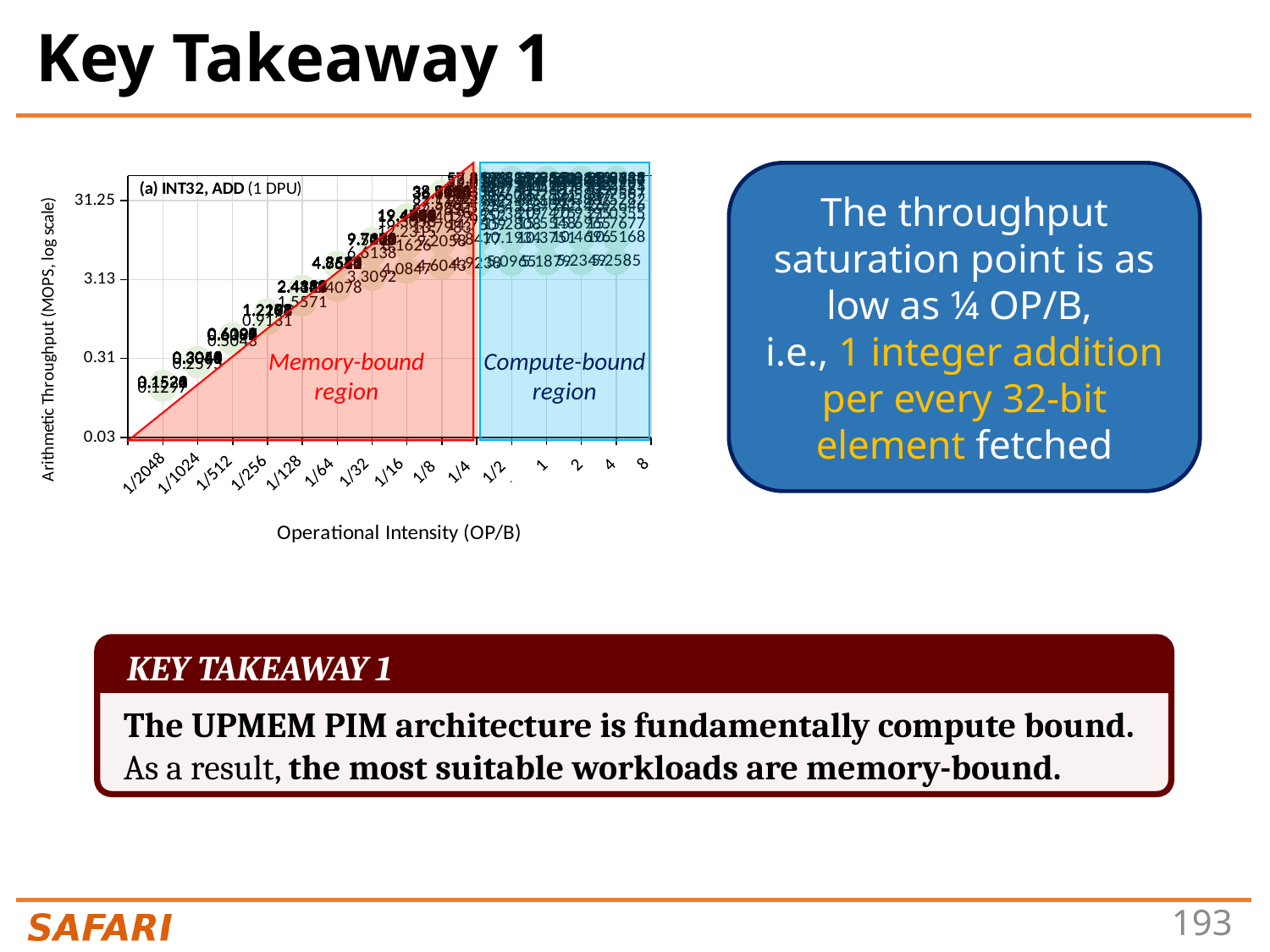
What kind of chart is shown on the slide? scatter plot Which has the higher arithmetic throughput: operational intensity 1/2048 or 1/4? 1/4 How does arithmetic throughput change as operational intensity increases from 1/2048 to 1/4? it rises What are the two shaded regions of the chart labelled? Memory-bound region and Compute-bound region Is the arithmetic throughput at operational intensity 1/2048 greater or less than 0.31? less What is the label of the x axis of the chart? Operational Intensity (OP/B) Which operational intensity has the lowest arithmetic throughput in the chart? 1/2048 Is the arithmetic throughput at operational intensity 1/128 greater or less than 3.13? less Is the arithmetic throughput at operational intensity 1/16 greater or less than 31.25? less How many tick labels are shown on the x axis of the chart? 15